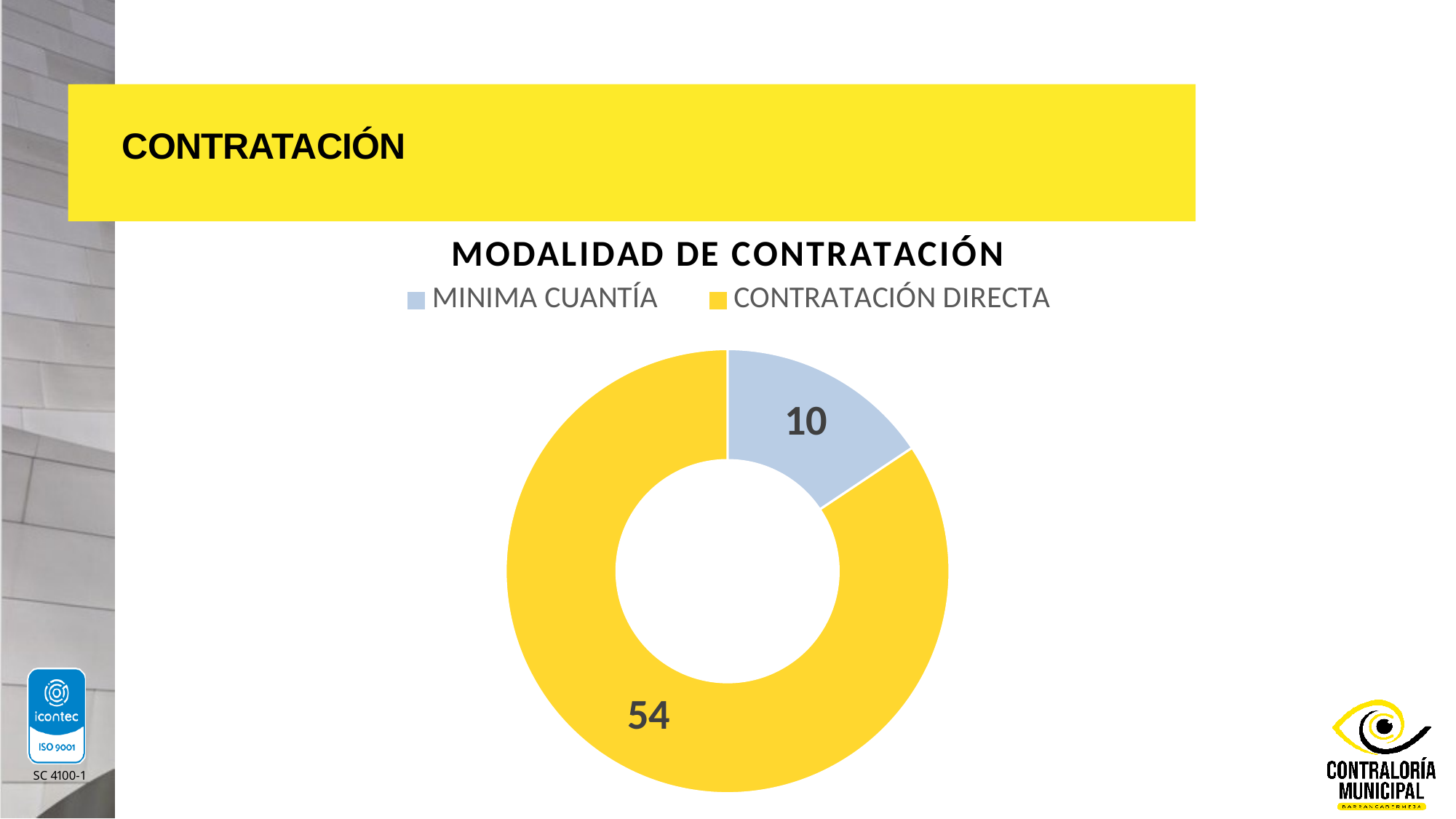
What kind of chart is shown on the slide? Doughnut chart What is the difference between the values for CONTRATACIÓN DIRECTA and MINIMA CUANTÍA? 44 How many categories does the chart show? 2 What is the value for CONTRATACIÓN DIRECTA? 54 What is the total of the two values shown in the chart? 64 What is the title of the chart? MODALIDAD DE CONTRATACIÓN What colour represents CONTRATACIÓN DIRECTA in the chart? Yellow How many entries does the legend list? 2 Which category has the largest value? CONTRATACIÓN DIRECTA Which category has the smallest value? MINIMA CUANTÍA Which is larger, MINIMA CUANTÍA or CONTRATACIÓN DIRECTA? CONTRATACIÓN DIRECTA What is the value for MINIMA CUANTÍA? 10